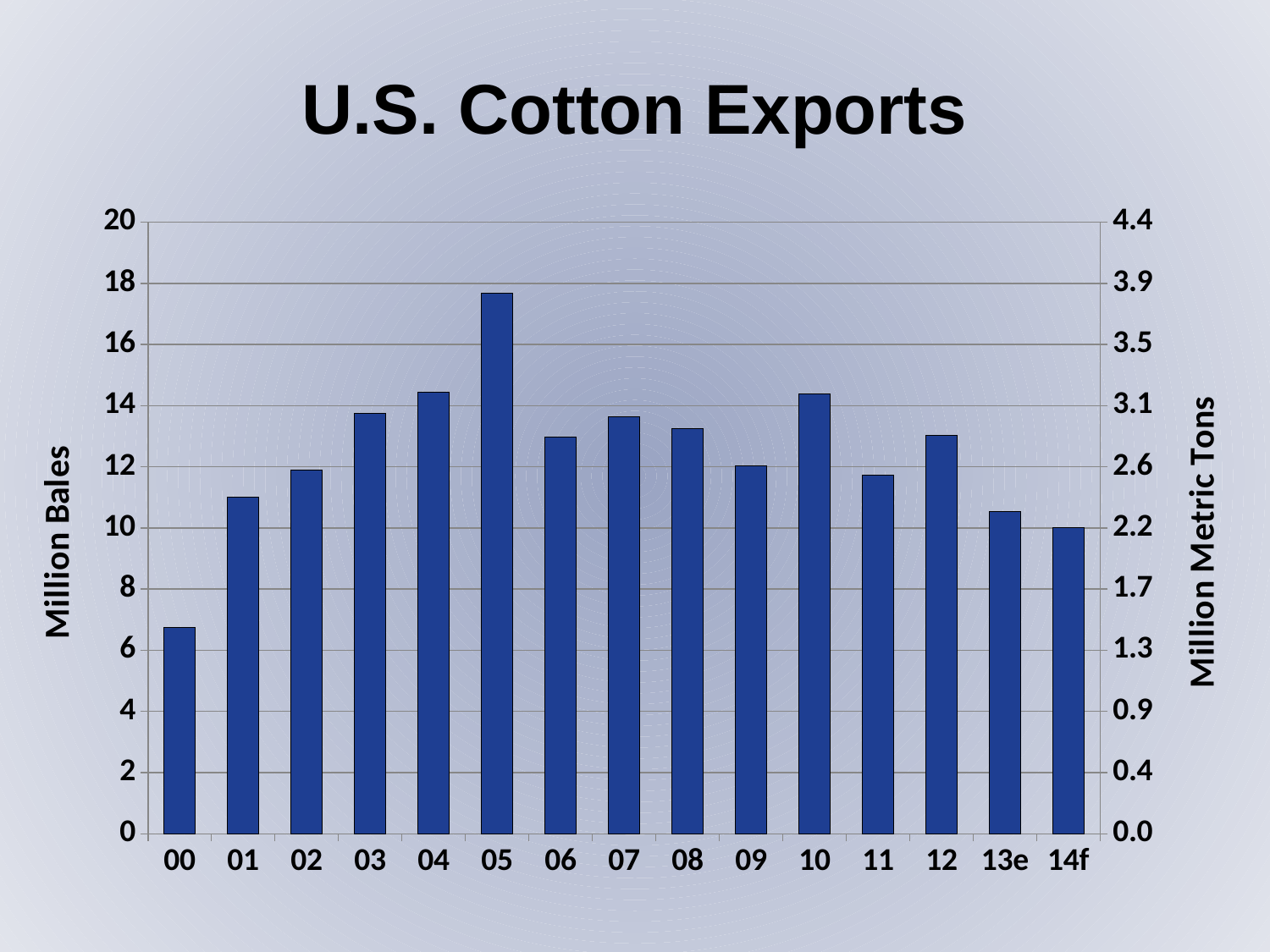
Is the value for 00 greater or less than 8 million bales? less What is the label on the left vertical axis? Million Bales Is the value for 05 greater or less than 16 million bales? greater Do exports rise or fall from 10 to 14f? fall Is the value for 06 greater or less than 12 million bales? greater What is the title of the chart? U.S. Cotton Exports Which year has the lowest cotton exports? 00 Which year has higher exports, 05 or 10? 05 How many years (bars) are shown on the x axis? 15 Which year has the highest cotton exports? 05 What kind of chart is shown on the slide? bar chart